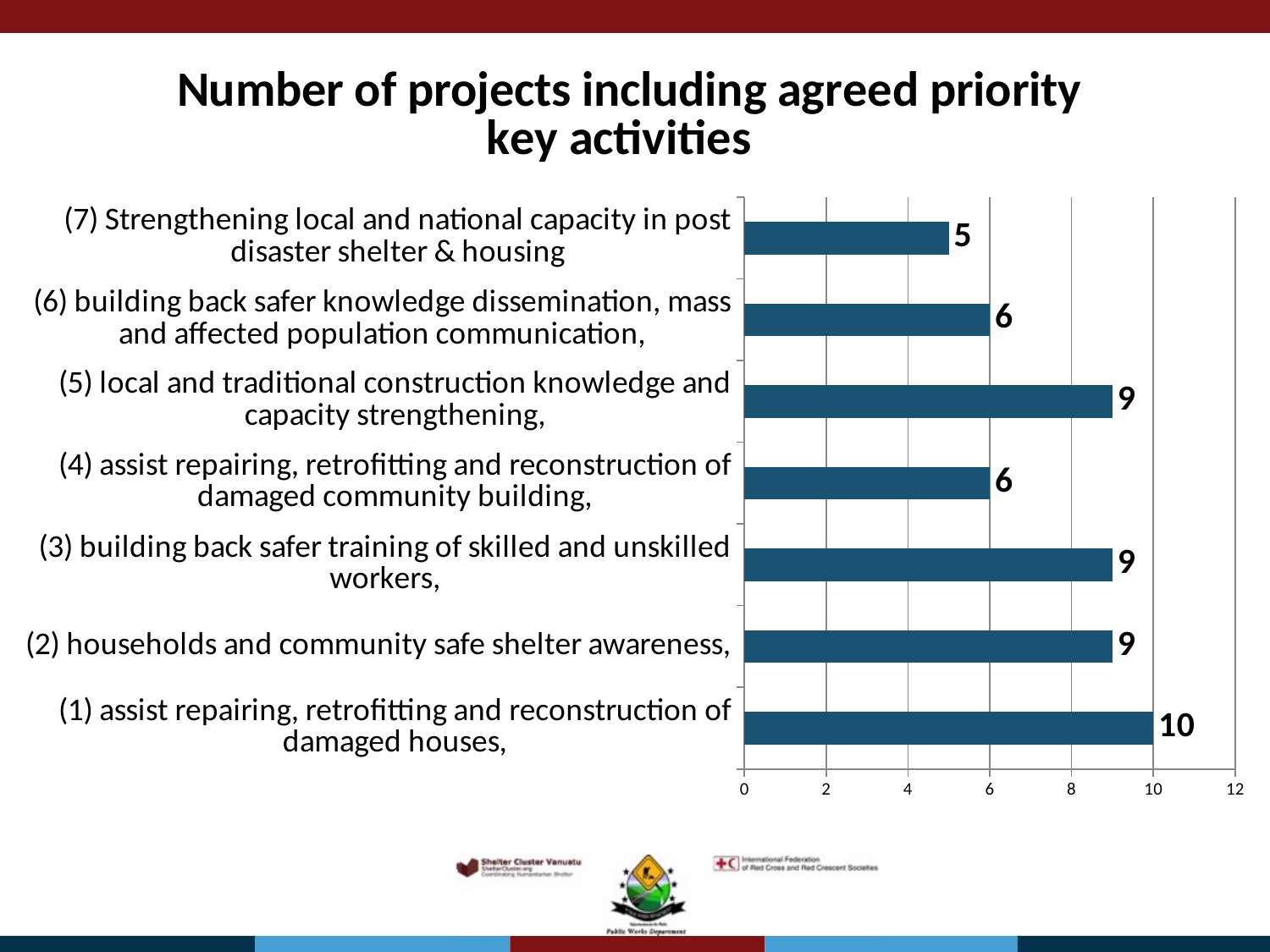
What is the title of the chart? Number of projects including agreed priority key activities What is the maximum value shown on the horizontal axis? 12 What is the number of projects for activity (7) Strengthening local and national capacity in post disaster shelter & housing? 5 Which activity has the highest number of projects? (1) assist repairing, retrofitting and reconstruction of damaged houses What is the difference in number of projects between activity (1) and activity (7)? 5 What is the number of projects for activity (1) assist repairing, retrofitting and reconstruction of damaged houses? 10 Which has more projects: activity (4) assist repairing, retrofitting and reconstruction of damaged community building, or activity (5) local and traditional construction knowledge and capacity strengthening? (5) local and traditional construction knowledge and capacity strengthening What kind of chart is shown on the slide? Bar chart How many activities have exactly 9 projects? 3 Which activity has the lowest number of projects? (7) Strengthening local and national capacity in post disaster shelter & housing How many activities (categories) are shown in the chart? 7 What is the number of projects for activity (6) building back safer knowledge dissemination, mass and affected population communication? 6